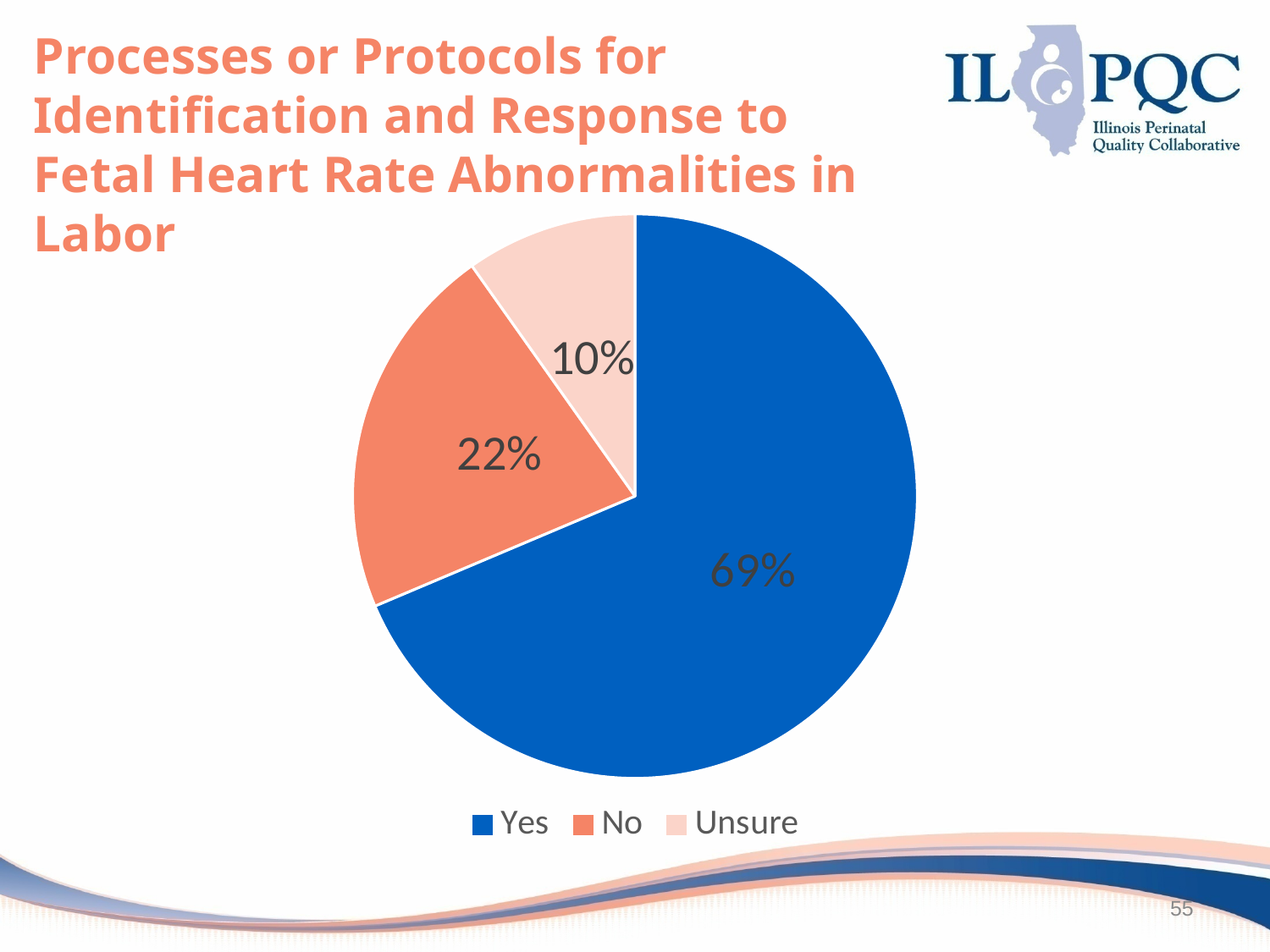
How many categories are shown in the pie chart? 3 What kind of chart is shown on the slide? Pie chart Which category has the largest slice of the pie chart? Yes What percentage of the pie chart is labelled No? 22% What share of the pie does the Yes slice represent? 69% Which category has the smallest slice of the pie chart? Unsure What colour is the Yes slice in the pie chart? Blue What percentage of the pie chart is labelled Unsure? 10% What percentage of the pie chart is labelled Yes? 69% Which slice is larger, No or Unsure? No What is the difference in percentage points between the Yes and No slices? 47 What is the difference in percentage points between the No and Unsure slices? 12